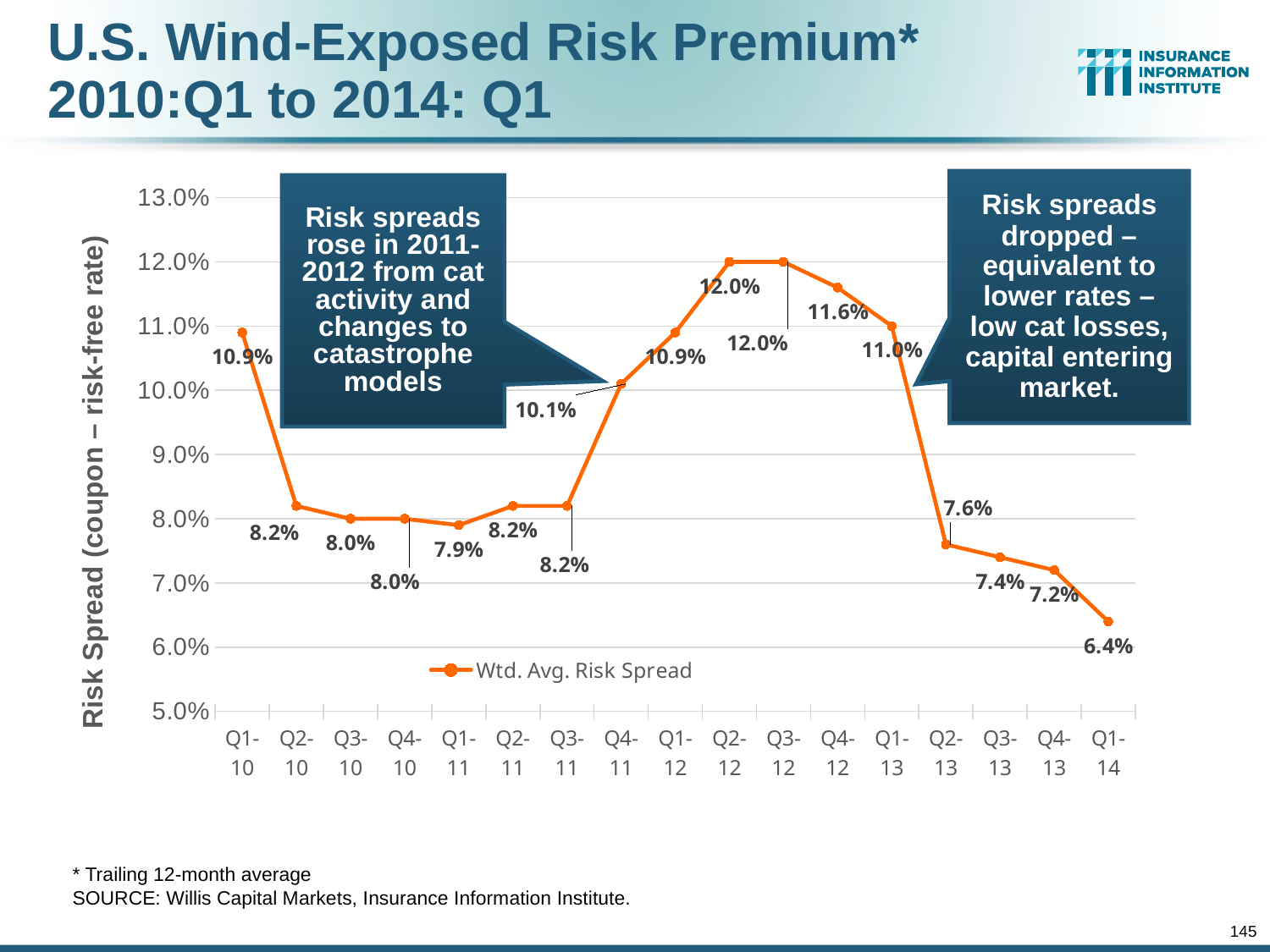
What is the difference between the risk spread in Q1-13 and Q2-13? 3.4% What is the weighted average risk spread for Q1-14? 6.4% What kind of chart is shown on the slide? line chart How many series does the legend list? 1 Does the risk spread rise or fall from Q1-13 to Q1-14? fall Which quarter has the lowest weighted average risk spread? Q1-14 Which is larger, the risk spread in Q4-12 or in Q1-10? Q4-12 What is the name of the series shown in the legend? Wtd. Avg. Risk Spread How many quarters are plotted on the chart? 17 What is the weighted average risk spread for Q1-10? 10.9% What is the highest weighted average risk spread value shown on the chart? 12.0% What is the weighted average risk spread for Q4-11? 10.1%